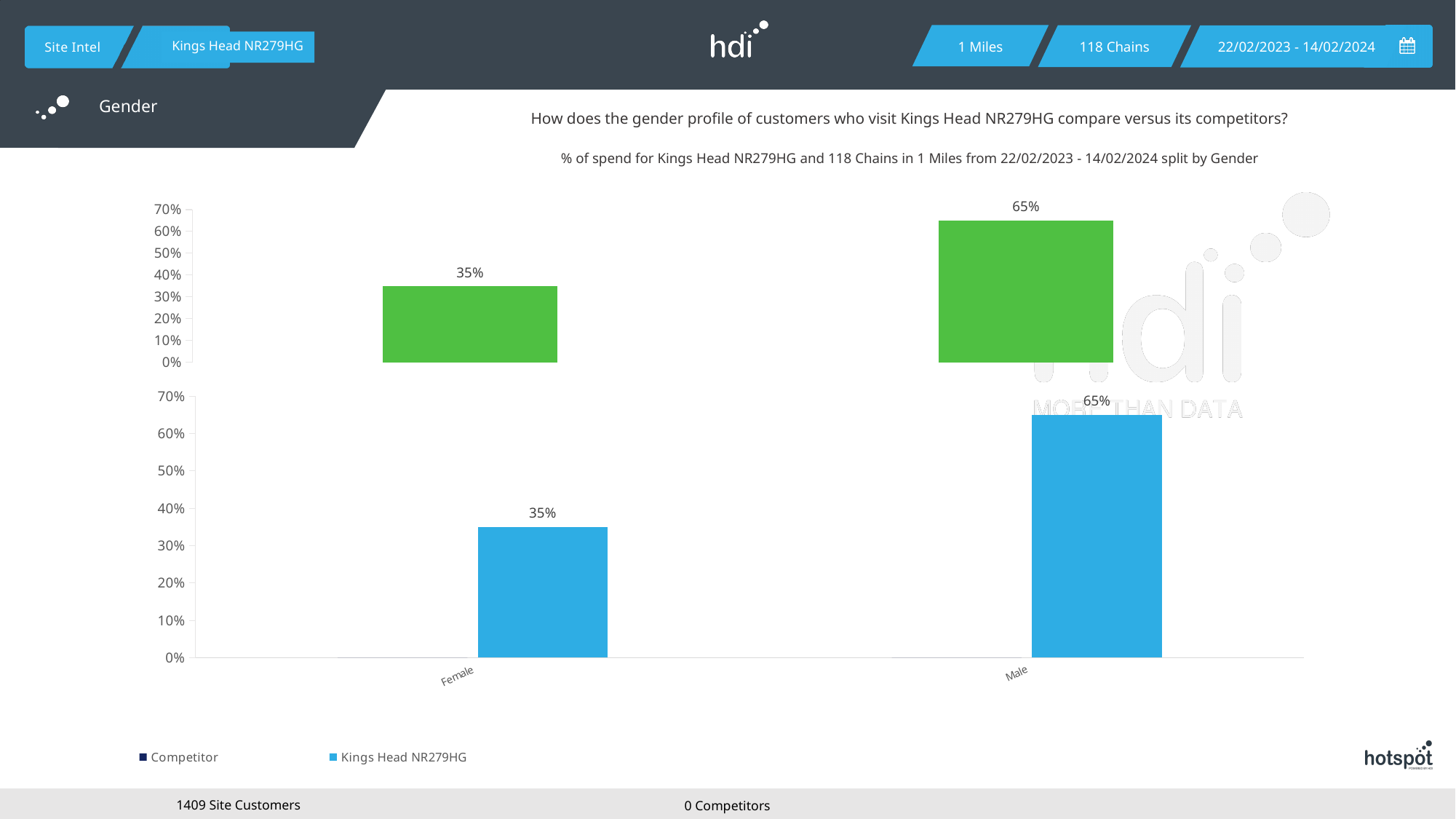
In the top chart, what is the value for the Female bar? 35% In the bottom chart, which category has the lowest value? Female In the bottom chart, what is the value for Female? 35% In the bottom chart, which category has the highest value? Male How many series does the legend at the bottom of the slide list? 2 What kind of chart is the bottom chart? bar chart In the top chart, is the Female bar greater or less than 40%? less In the top chart, what is the value for the Male bar? 65% In the bottom chart, what is the difference between the Male and Female values? 30% How many categories are shown on the x axis of the bottom chart? 2 In the bottom chart, what is the value for Male? 65% In the bottom chart, is the Male value greater or less than 60%? greater